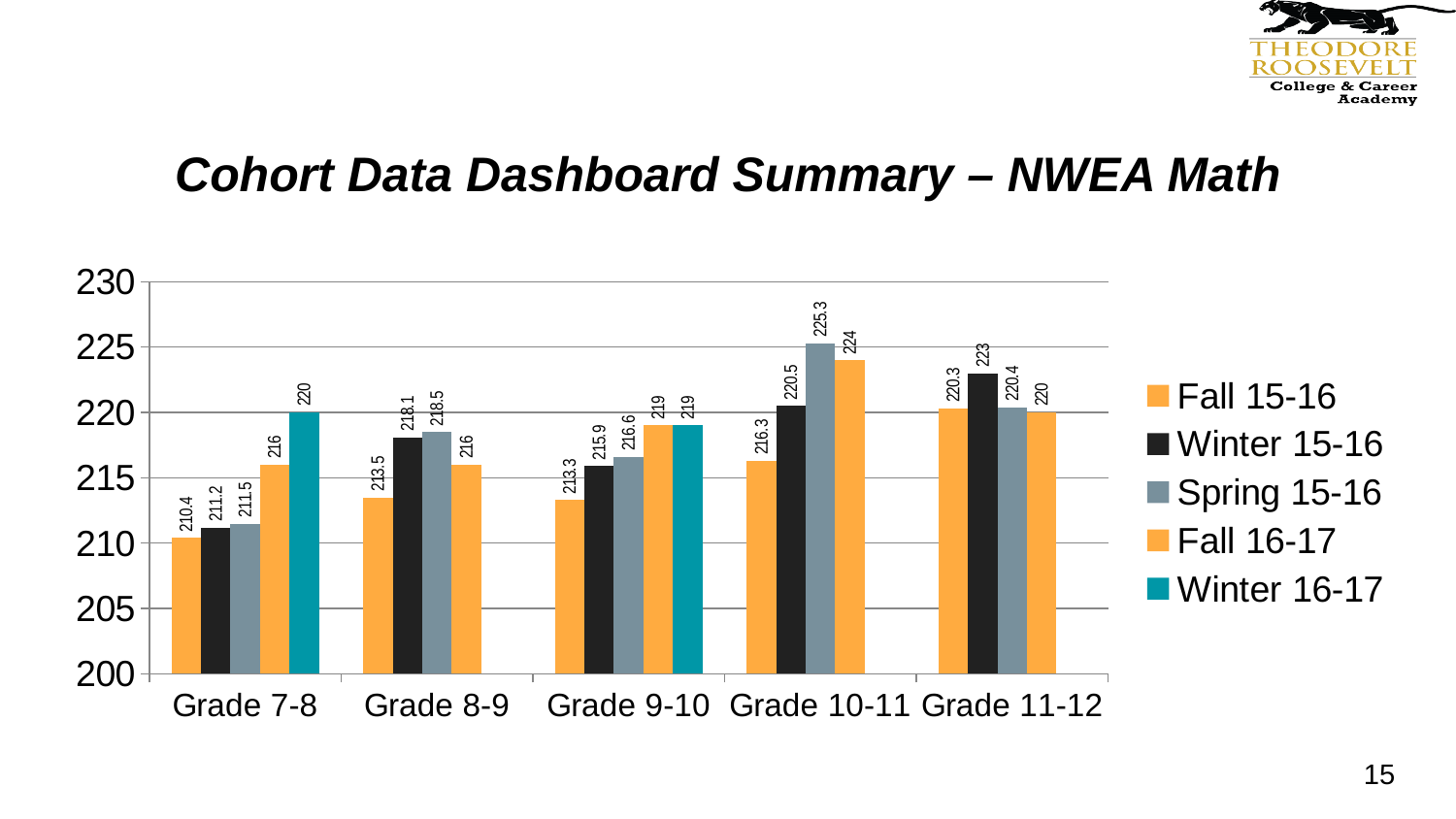
What kind of chart is shown on the slide? Bar chart Which grade cohorts have a Winter 16-17 bar? Grade 7-8 and Grade 9-10 What is the difference between the Winter 16-17 and Fall 15-16 values for Grade 7-8? 9.6 Which grade cohort has the lowest Fall 15-16 value? Grade 7-8 Which grade cohort has the highest Spring 15-16 value? Grade 10-11 What is the Winter 15-16 value for Grade 11-12? 223 How many grade cohorts are shown on the x axis? 5 What is the Spring 15-16 value for Grade 10-11? 225.3 What is the Winter 16-17 value for Grade 9-10? 219 How many series does the legend list? 5 Which is larger for Grade 8-9: the Spring 15-16 value or the Fall 16-17 value? Spring 15-16 What is the Fall 15-16 value for Grade 7-8? 210.4